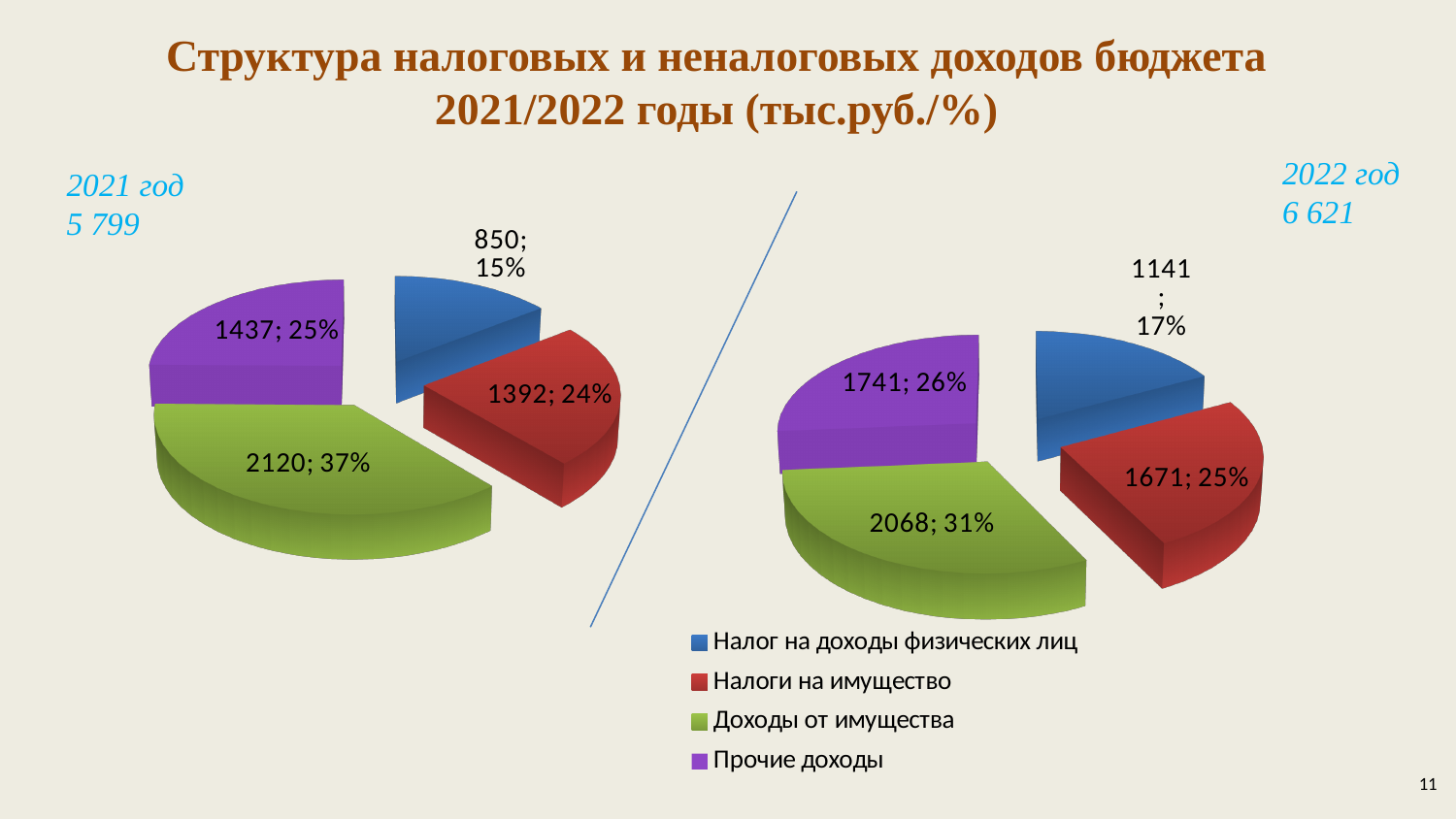
On the 2022 pie chart, which category has the smallest value? Налог на доходы физических лиц On the 2022 pie chart, what is the difference between Доходы от имущества and Налоги на имущество? 397 How many categories does the 2021 pie chart show? 4 What type of chart is used for the 2022 data? Pie chart On the 2021 pie chart, what share does Прочие доходы have? 25% On the 2022 pie chart, what is the value for Налог на доходы физических лиц? 1141 On the 2021 pie chart, which category has the largest value? Доходы от имущества Which colour represents Налоги на имущество in the legend? Red On the 2021 pie chart, what is the value for Доходы от имущества? 2120 On the 2022 pie chart, what share does Доходы от имущества have? 31% What is the total shown for the 2022 pie chart? 6 621 On the 2021 pie chart, which is larger: Налоги на имущество or Прочие доходы? Прочие доходы